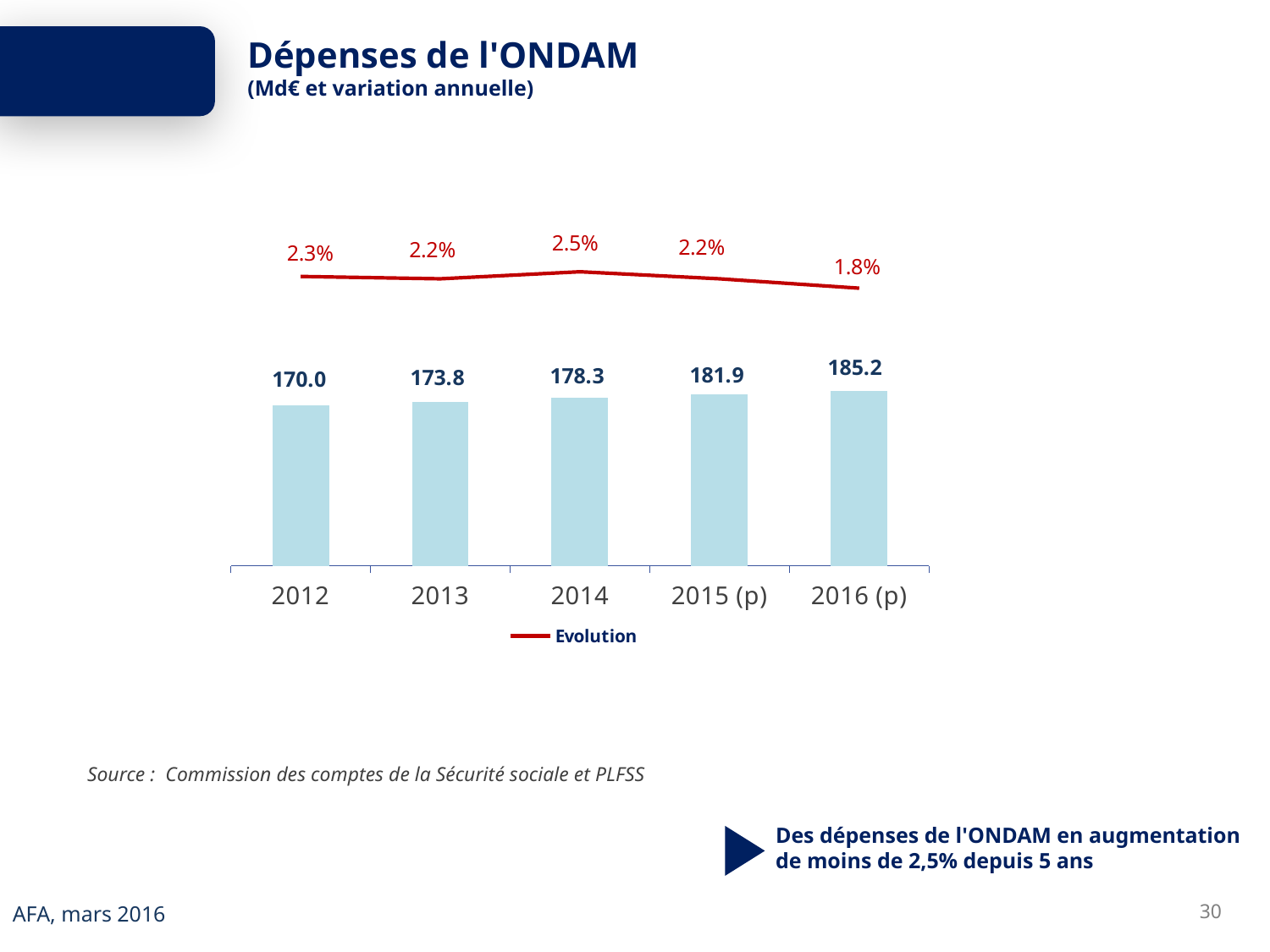
Which year has the lowest annual variation on the Evolution line? 2016 (p) What is the annual variation (Evolution) shown for 2016 (p)? 1.8% Which year has the highest ONDAM expenditure bar? 2016 (p) What is the name of the series listed in the legend? Evolution How many years are shown on the x axis of the chart? 5 What is the ONDAM expenditure value shown for 2012? 170.0 What is the ONDAM expenditure value shown for 2014? 178.3 How many series does the legend list? 1 Is the ONDAM expenditure bar for 2015 (p) larger or smaller than the bar for 2013? larger Do the ONDAM expenditure bars rise or fall from 2012 to 2016 (p)? rise Which year has the highest annual variation on the Evolution line? 2014 What is the difference between the ONDAM expenditure for 2016 (p) and 2012? 15.2